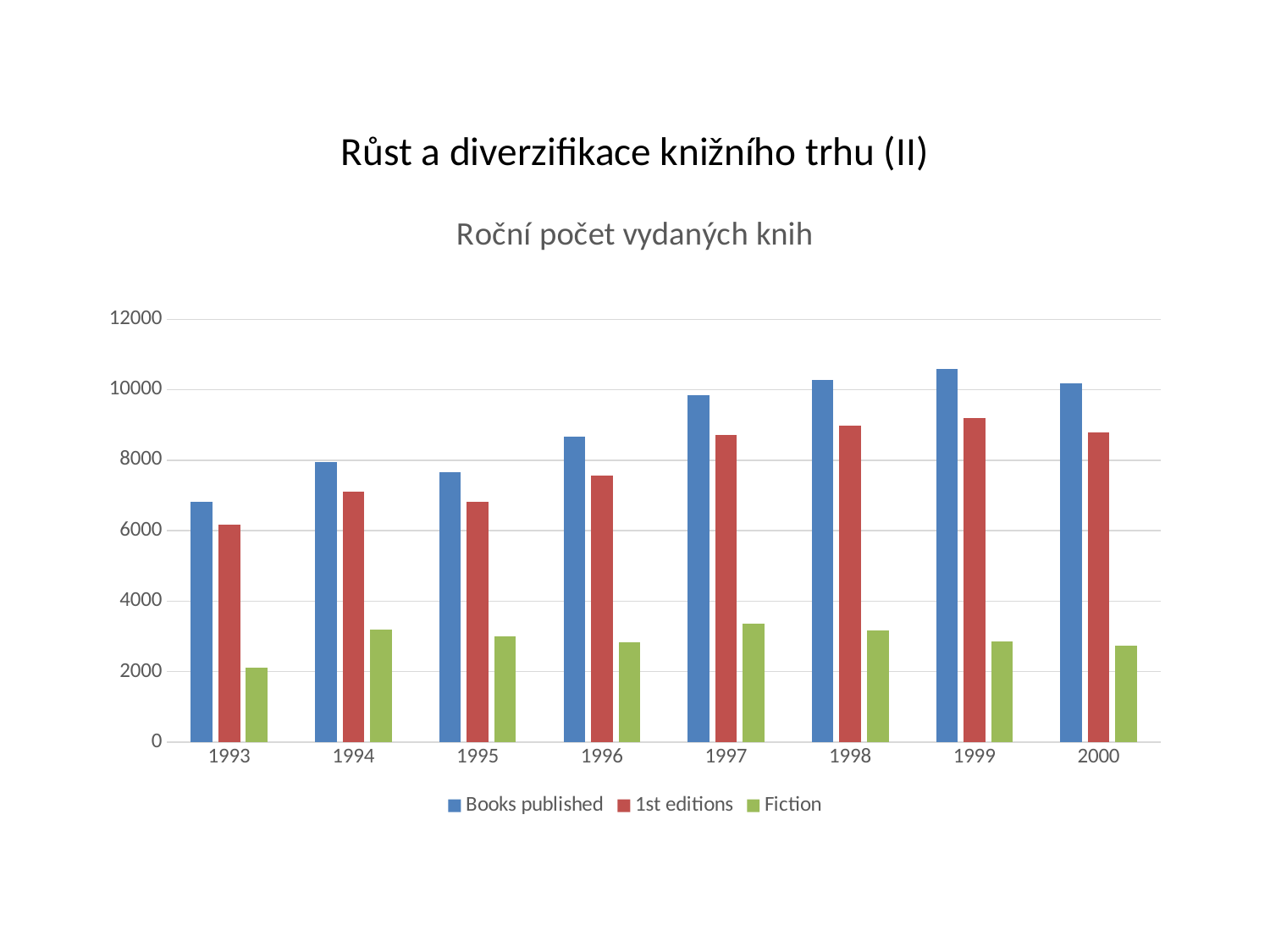
Which is larger, the value for Fiction in 1993 or in 1994? 1994 What is the title of the chart? Roční počet vydaných knih In which year is the value for Fiction lowest? 1993 In which year is the value for Books published lowest? 1993 In which year is the value for Books published highest? 1999 What kind of chart is shown on the slide? bar chart How many series does the legend list? 3 Is the value for Books published in 1999 greater or less than 10000? greater Is the value for Fiction in 1997 greater or less than 4000? less Is the value for 1st editions in 1996 greater or less than 8000? less Which is larger, the value for Books published in 1994 or in 1995? 1994 How many years are shown on the x axis? 8